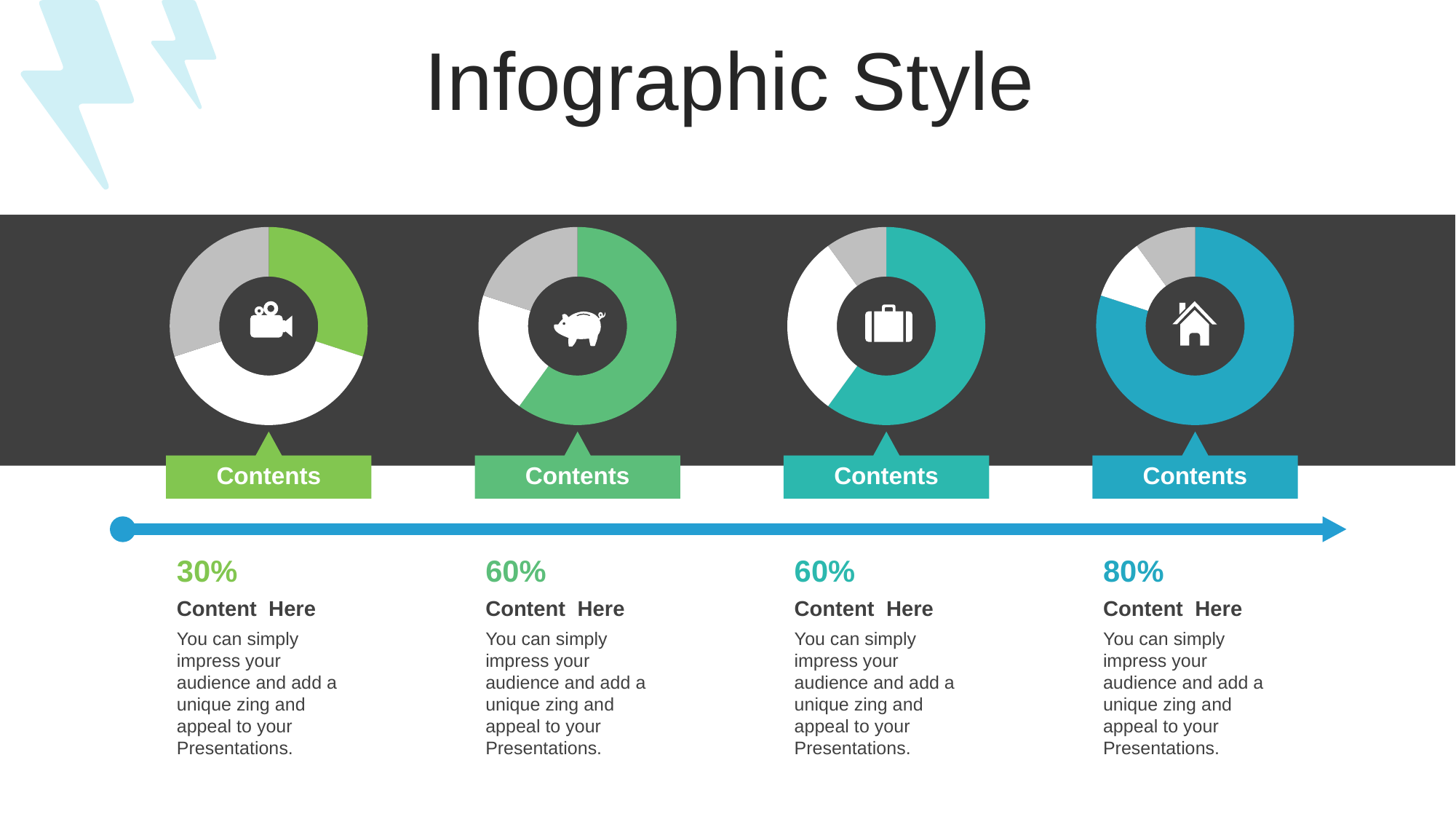
What percentage is shown for the second doughnut chart (with the piggy bank icon)? 60% What percentage is shown for the third doughnut chart (with the briefcase icon)? 60% What colour is the main filled segment of the rightmost doughnut chart? Blue Which doughnut chart has the lowest percentage? The leftmost chart (video camera icon), 30% Which is larger, the percentage for the leftmost doughnut chart or the percentage for the rightmost doughnut chart? The rightmost chart (80%) Which doughnut chart has the highest percentage? The rightmost chart (house icon), 80% What percentage is shown for the leftmost doughnut chart (with the video camera icon)? 30% Is the coloured portion of the leftmost doughnut chart greater or less than 50%? less How many doughnut charts are on the slide? 4 What percentage is shown for the rightmost doughnut chart (with the house icon)? 80% What kind of charts are shown on the dark band of the slide? Doughnut charts What is the difference between the percentage of the rightmost doughnut chart and the leftmost doughnut chart? 50 percentage points